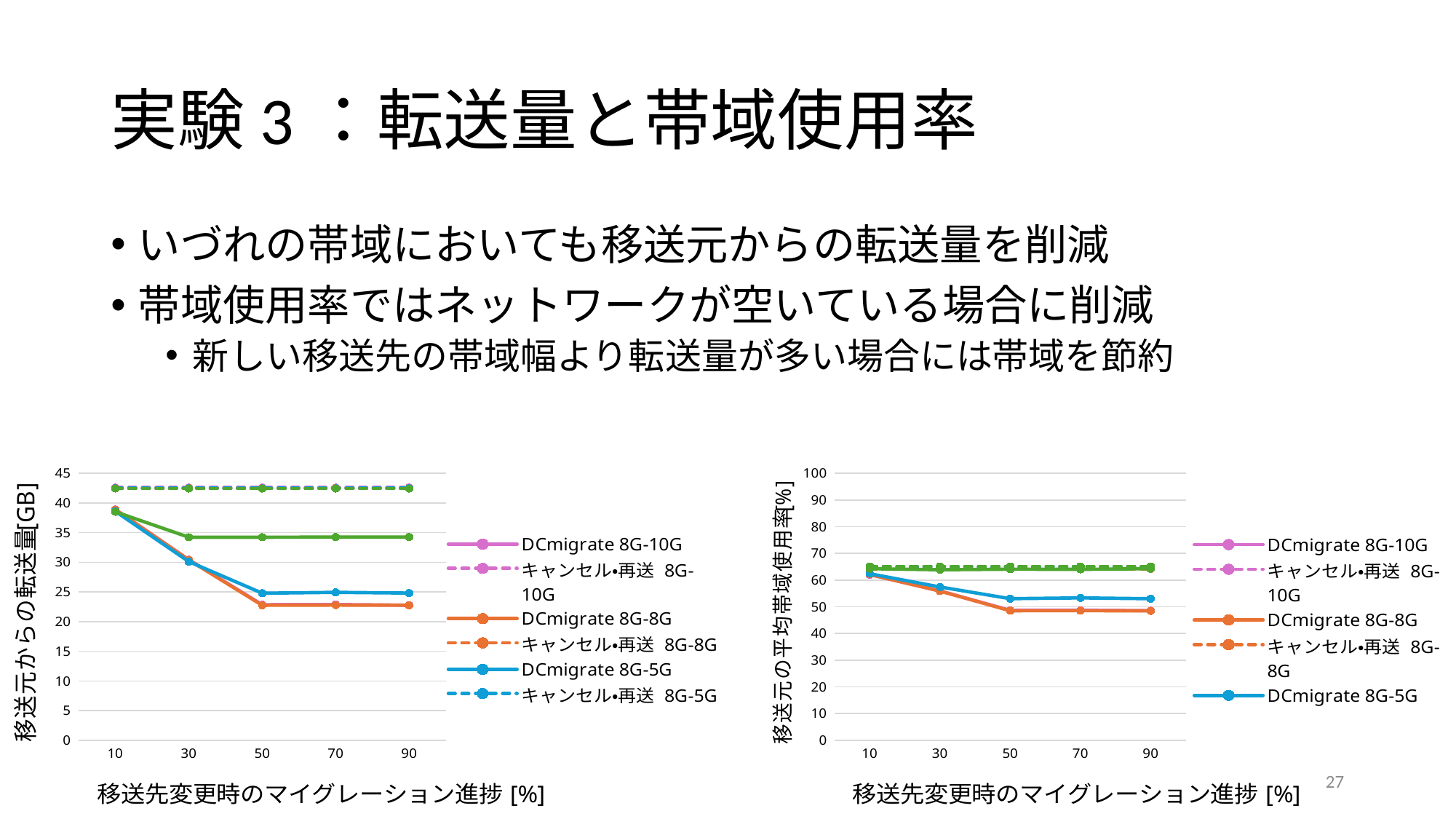
In the left chart (移送元からの転送量[GB]), is the value for DCmigrate 8G-8G at 90 greater or less than 25? less How many series does the legend of the right chart (移送元の平均帯域使用率[%]) list? 5 What kind of chart is the left chart (移送元からの転送量[GB])? line chart How many x-axis points are plotted in the left chart (移送元からの転送量[GB])? 5 In the right chart (移送元の平均帯域使用率[%]), is the value for キャンセル•再送 8G-10G at 30 greater or less than 60? greater How many series does the legend of the left chart (移送元からの転送量[GB]) list? 6 What is the x-axis title of the right chart (移送元の平均帯域使用率[%])? 移送先変更時のマイグレーション進捗 [%] In the left chart (移送元からの転送量[GB]), is the value for DCmigrate 8G-10G at 70 greater or less than 30? less In the left chart (移送元からの転送量[GB]), does the value for DCmigrate 8G-8G rise or fall from 10 to 50? fall